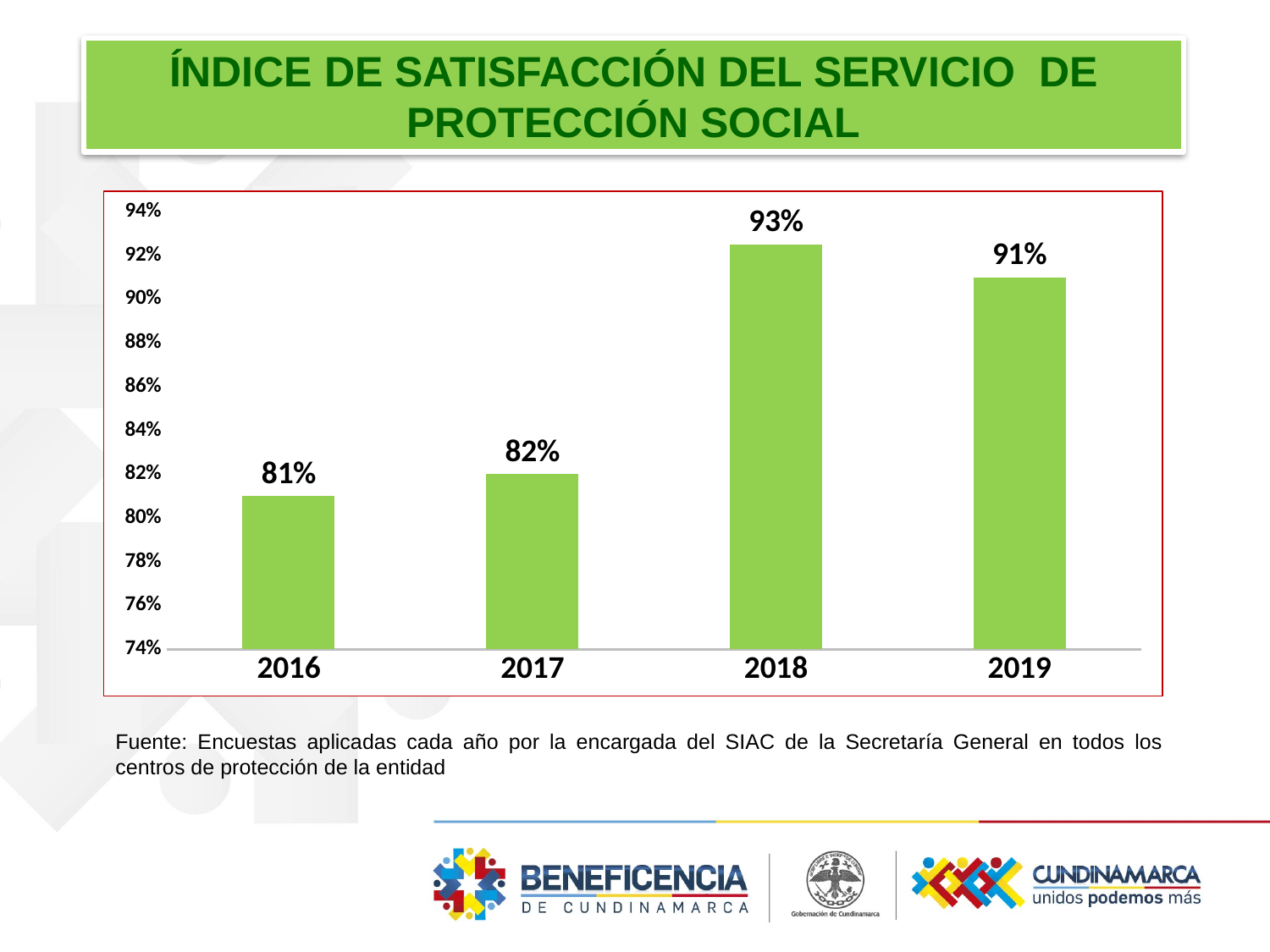
Is the value for 2017 greater or less than 86%? less Which year has the highest satisfaction index? 2018 What is the difference between the 2018 and 2016 values? 12% How many years are shown on the x axis? 4 What kind of chart is shown on the slide? Bar chart What is the satisfaction index value for 2018? 93% Which is larger, the value for 2017 or the value for 2019? 2019 What is the difference between the 2018 and 2019 values? 2% What is the title of the slide above the chart? ÍNDICE DE SATISFACCIÓN DEL SERVICIO DE PROTECCIÓN SOCIAL What is the satisfaction index value for 2016? 81% What is the satisfaction index value for 2019? 91% Which year has the lowest satisfaction index? 2016